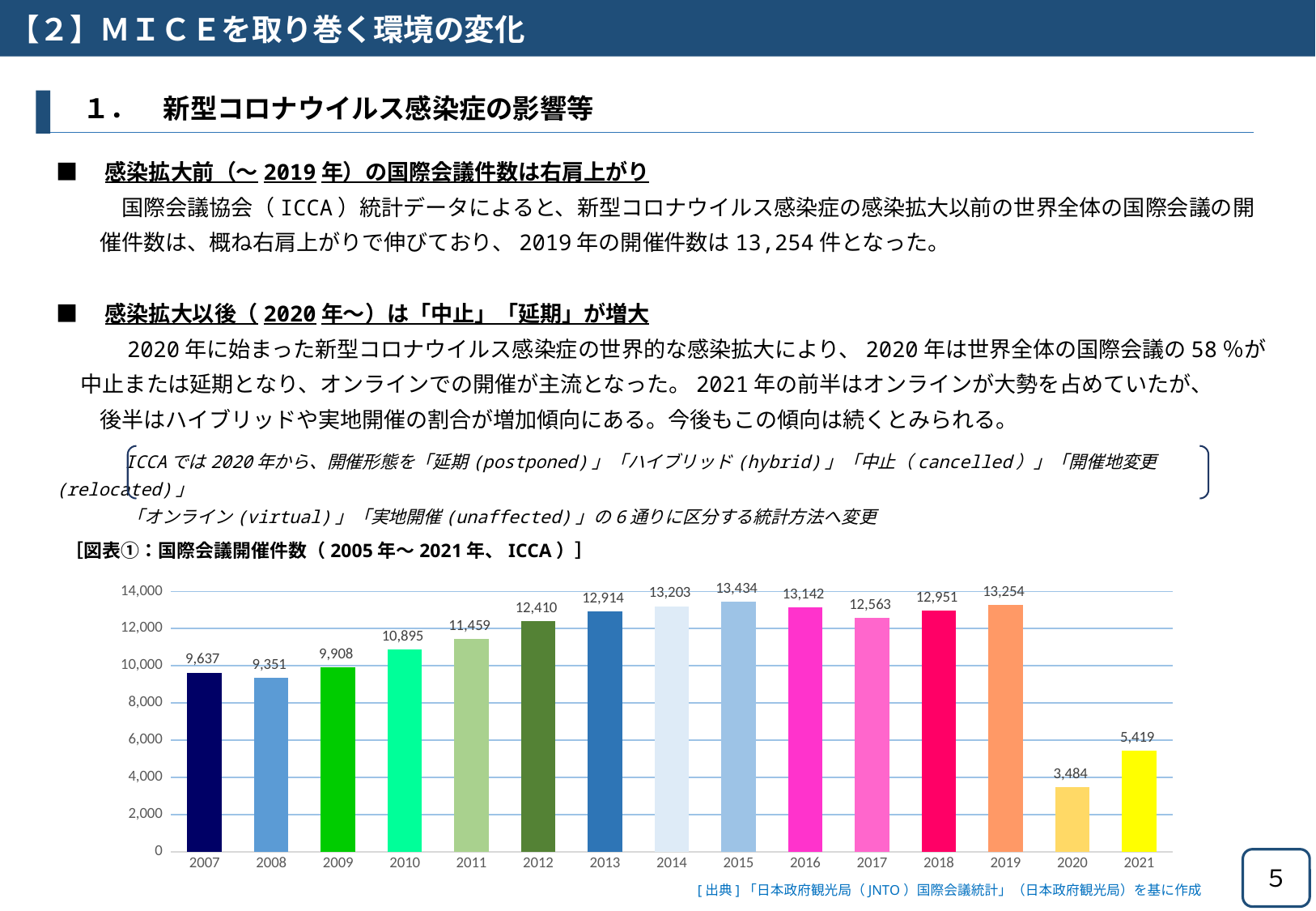
What is the difference between the values for 2019 and 2018? 303 What is the value for 2019? 13,254 Is the value for 2010 greater or less than 10,000? greater What is the value for 2012? 12,410 Which is larger, the value for 2014 or the value for 2016? 2014 What is the difference between the values for 2021 and 2020? 1,935 Which year has the lowest value? 2020 How many years are shown on the x axis? 15 Do the values rise or fall from 2008 to 2015? rise Which year has the highest value? 2015 What is the value for 2020? 3,484 What kind of chart is this? bar chart